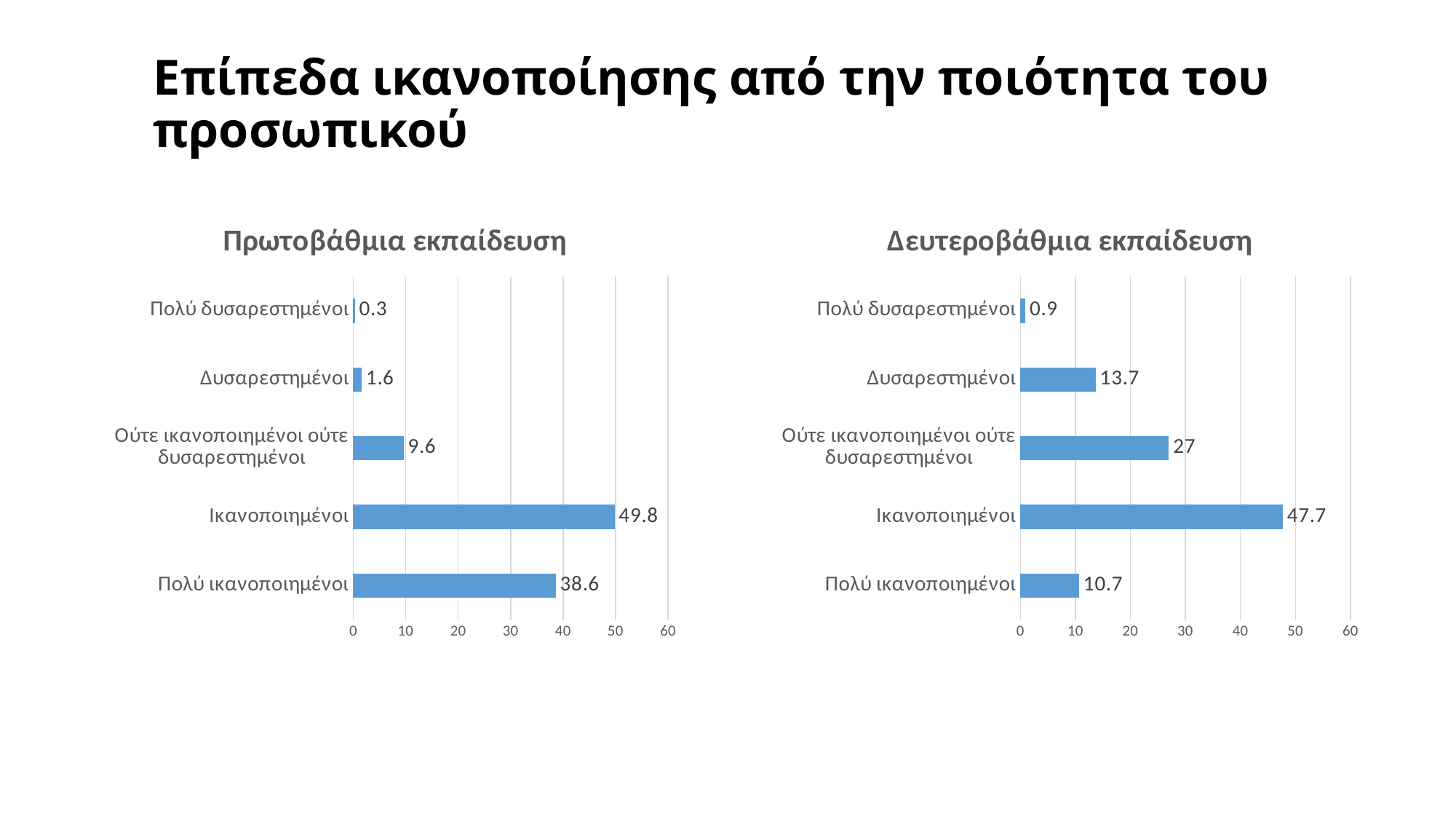
In the 'Δευτεροβάθμια εκπαίδευση' chart, which is larger: 'Δυσαρεστημένοι' or 'Πολύ ικανοποιημένοι'? Δυσαρεστημένοι In the 'Πρωτοβάθμια εκπαίδευση' chart, is the value for 'Πολύ ικανοποιημένοι' greater or less than 30? greater How many categories does the 'Δευτεροβάθμια εκπαίδευση' chart show? 5 In the 'Δευτεροβάθμια εκπαίδευση' chart, what is the value for 'Δυσαρεστημένοι'? 13.7 What kind of chart is the 'Πρωτοβάθμια εκπαίδευση' chart? bar chart In the 'Πρωτοβάθμια εκπαίδευση' chart, which category has the lowest value? Πολύ δυσαρεστημένοι What is the title of the chart on the right side of the slide? Δευτεροβάθμια εκπαίδευση In the 'Πρωτοβάθμια εκπαίδευση' chart, what is the value for 'Ούτε ικανοποιημένοι ούτε δυσαρεστημένοι'? 9.6 In the 'Δευτεροβάθμια εκπαίδευση' chart, what is the difference between 'Ούτε ικανοποιημένοι ούτε δυσαρεστημένοι' and 'Πολύ ικανοποιημένοι'? 16.3 In the 'Δευτεροβάθμια εκπαίδευση' chart, which category has the highest value? Ικανοποιημένοι In the 'Πρωτοβάθμια εκπαίδευση' chart, what is the difference between 'Ικανοποιημένοι' and 'Πολύ ικανοποιημένοι'? 11.2 In the 'Πρωτοβάθμια εκπαίδευση' chart, what is the value for 'Ικανοποιημένοι'? 49.8